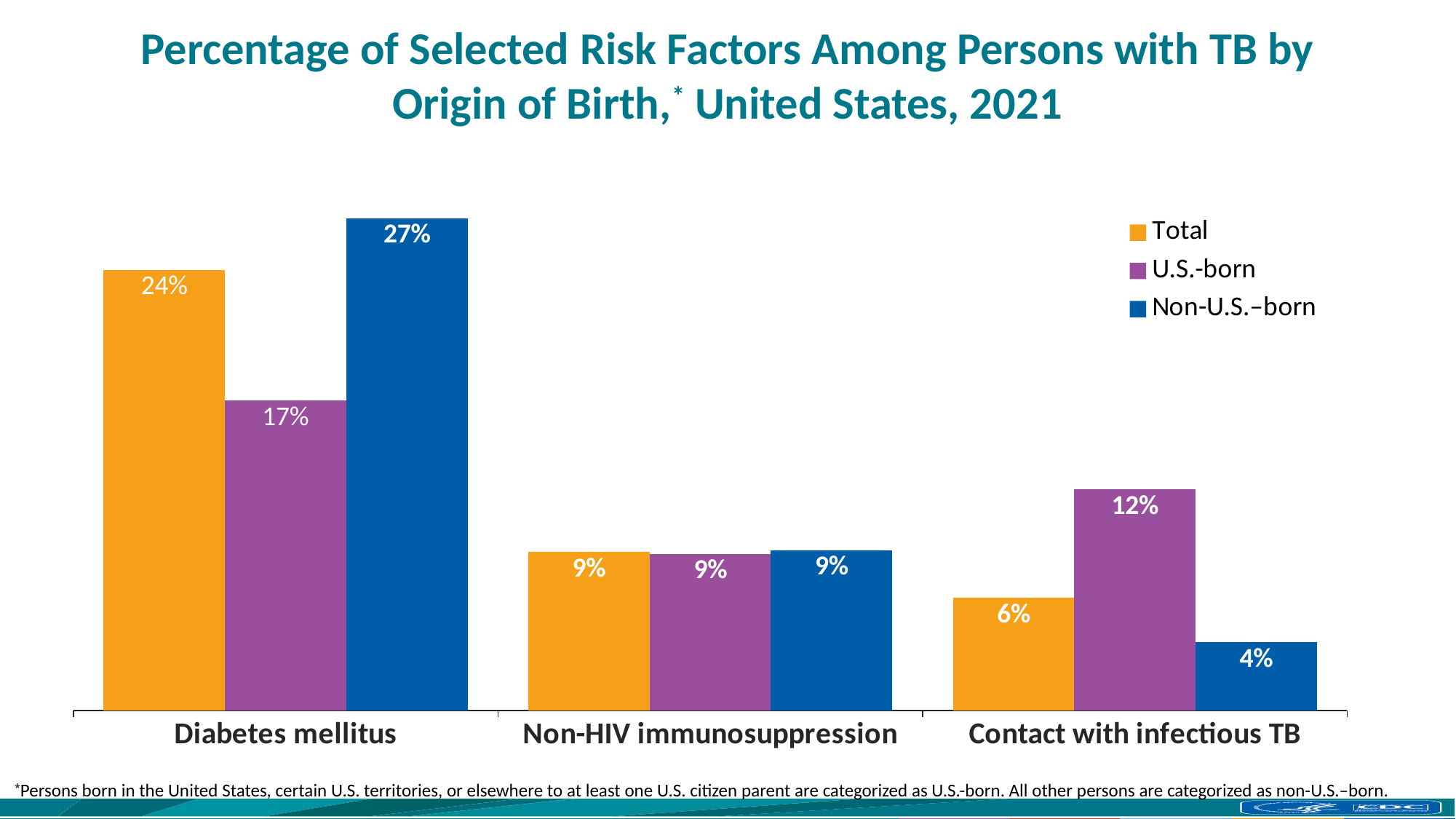
Which risk factor has the highest Total percentage? Diabetes mellitus What is the Total percentage for Non-HIV immunosuppression? 9% What is the U.S.-born percentage for Contact with infectious TB? 12% How many risk factor categories are shown on the x axis? 3 What is the Non-U.S.-born percentage for Diabetes mellitus? 27% Which colour represents the Total series in the legend? Orange Which risk factor has the lowest Non-U.S.-born percentage? Contact with infectious TB What is the difference between the Non-U.S.-born and U.S.-born percentages for Diabetes mellitus? 10% For Contact with infectious TB, which is larger: the U.S.-born or the Non-U.S.-born percentage? U.S.-born What is the difference between the U.S.-born and Non-U.S.-born percentages for Contact with infectious TB? 8% What kind of chart is shown on the slide? Bar chart How many series does the legend list? 3